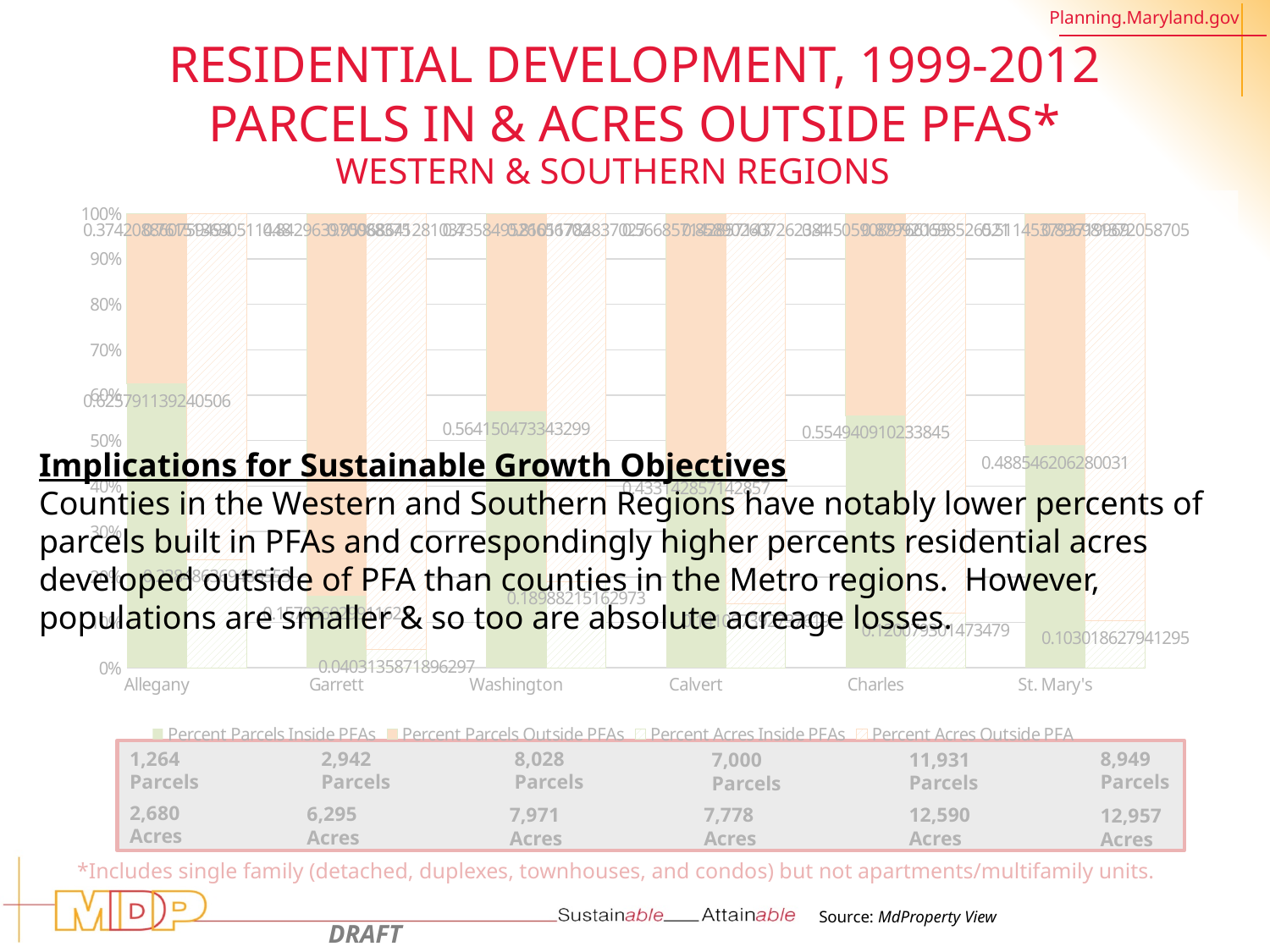
Is the Percent Parcels Inside PFAs value for Garrett greater or less than 10%? greater What is the Percent Parcels Inside PFAs value labeled for Charles? 0.554940910233845 What is the Percent Parcels Inside PFAs value labeled for Allegany? 0.625791139240506 How many counties are shown on the x axis of the chart? 6 Which series is listed first in the chart legend? Percent Parcels Inside PFAs What is the Percent Parcels Inside PFAs value labeled for St. Mary's? 0.488546206280031 Which county has the highest Percent Parcels Inside PFAs? Allegany What is the Percent Parcels Inside PFAs value labeled for Washington? 0.564150473343299 Which county has the lowest Percent Parcels Inside PFAs? Garrett What type of chart is shown on the slide? Stacked bar chart How many series does the chart legend list? 4